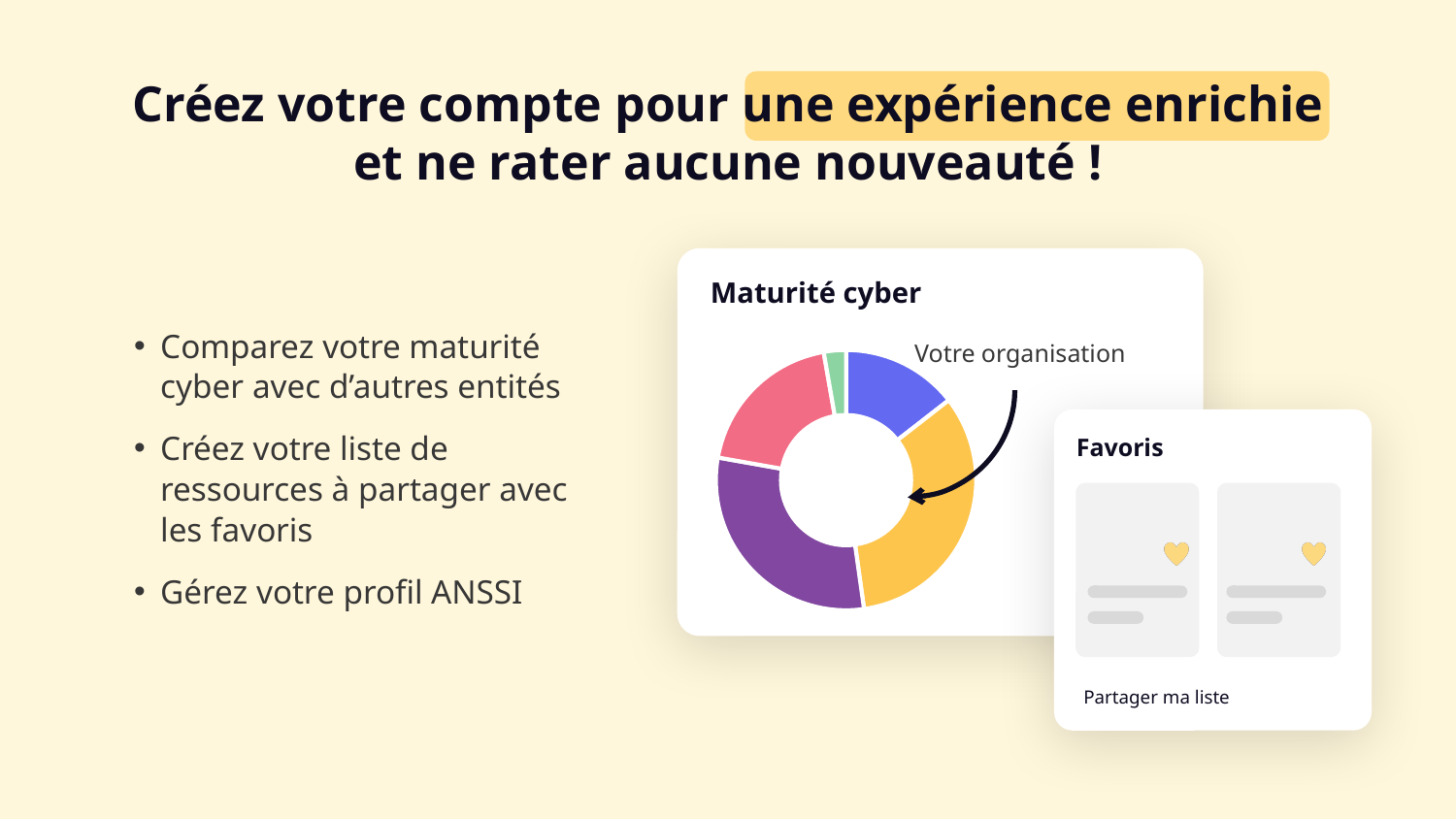
How many slices does the "Maturité cyber" donut chart have? 5 In the "Maturité cyber" chart, is the purple slice or the blue slice larger? The purple slice Which colour slice of the "Maturité cyber" chart is labelled "Votre organisation"? Yellow What kind of chart is shown in the "Maturité cyber" panel? Donut (pie) chart In the "Maturité cyber" chart, is the yellow slice or the blue slice larger? The yellow slice Which slice of the "Maturité cyber" chart is the smallest? The green slice What is the title of the chart on the slide? Maturité cyber In the "Maturité cyber" chart, is the pink slice or the green slice larger? The pink slice Which slice of the "Maturité cyber" chart is the largest? The yellow slice (Votre organisation)